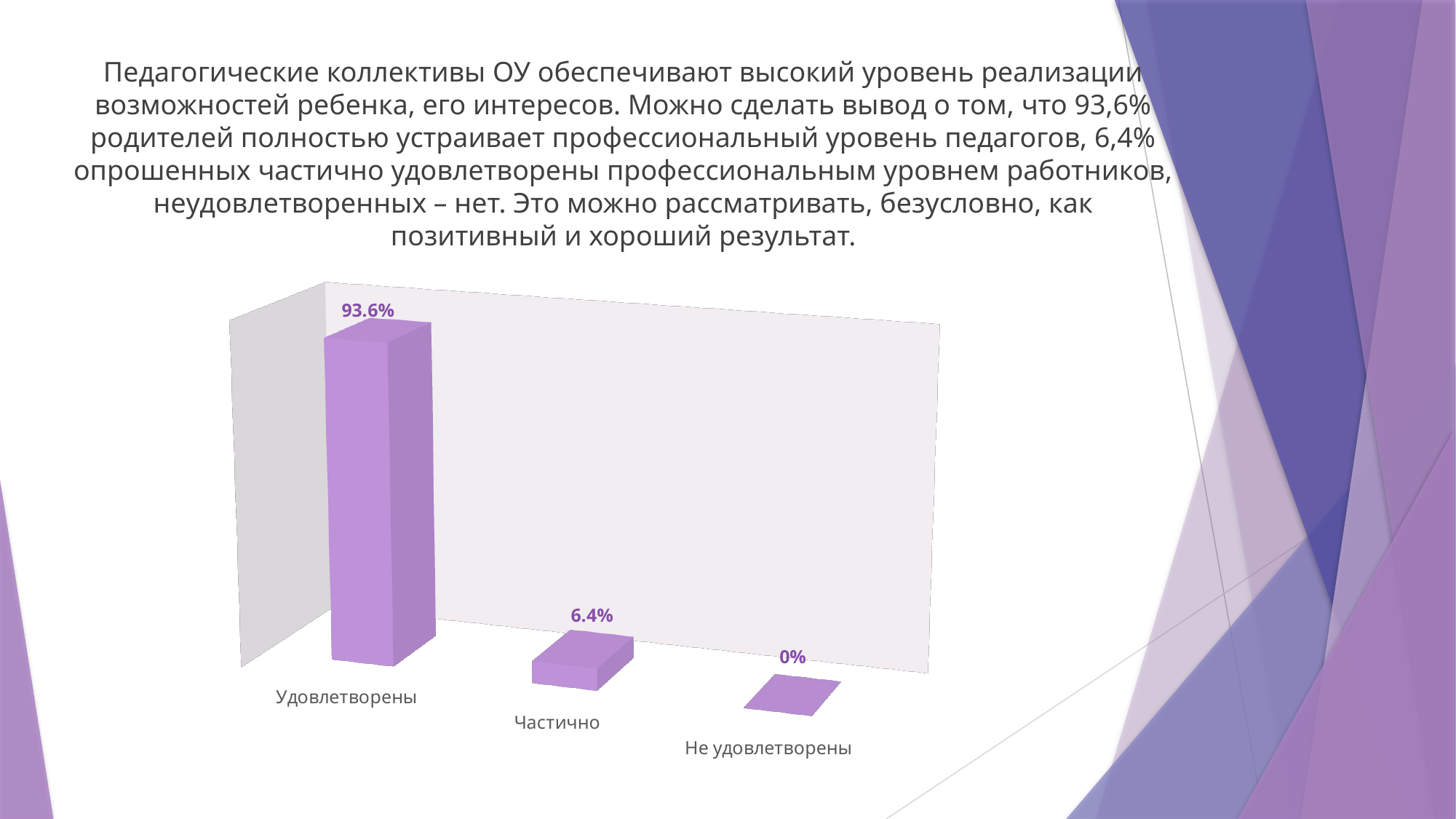
How many categories are shown in the chart? 3 What colour are the bars in the chart? Purple Do the values rise or fall from left to right across the categories? Fall What kind of chart is shown on the slide? Bar chart Which category has the highest value? Удовлетворены What is the value for Частично? 6.4% Which category has the lowest value? Не удовлетворены Which is larger, the value for Частично or the value for Не удовлетворены? Частично What is the total of the three values shown in the chart? 100% What is the value for Удовлетворены? 93.6% What is the difference between the values for Удовлетворены and Частично? 87.2% What is the value for Не удовлетворены? 0%